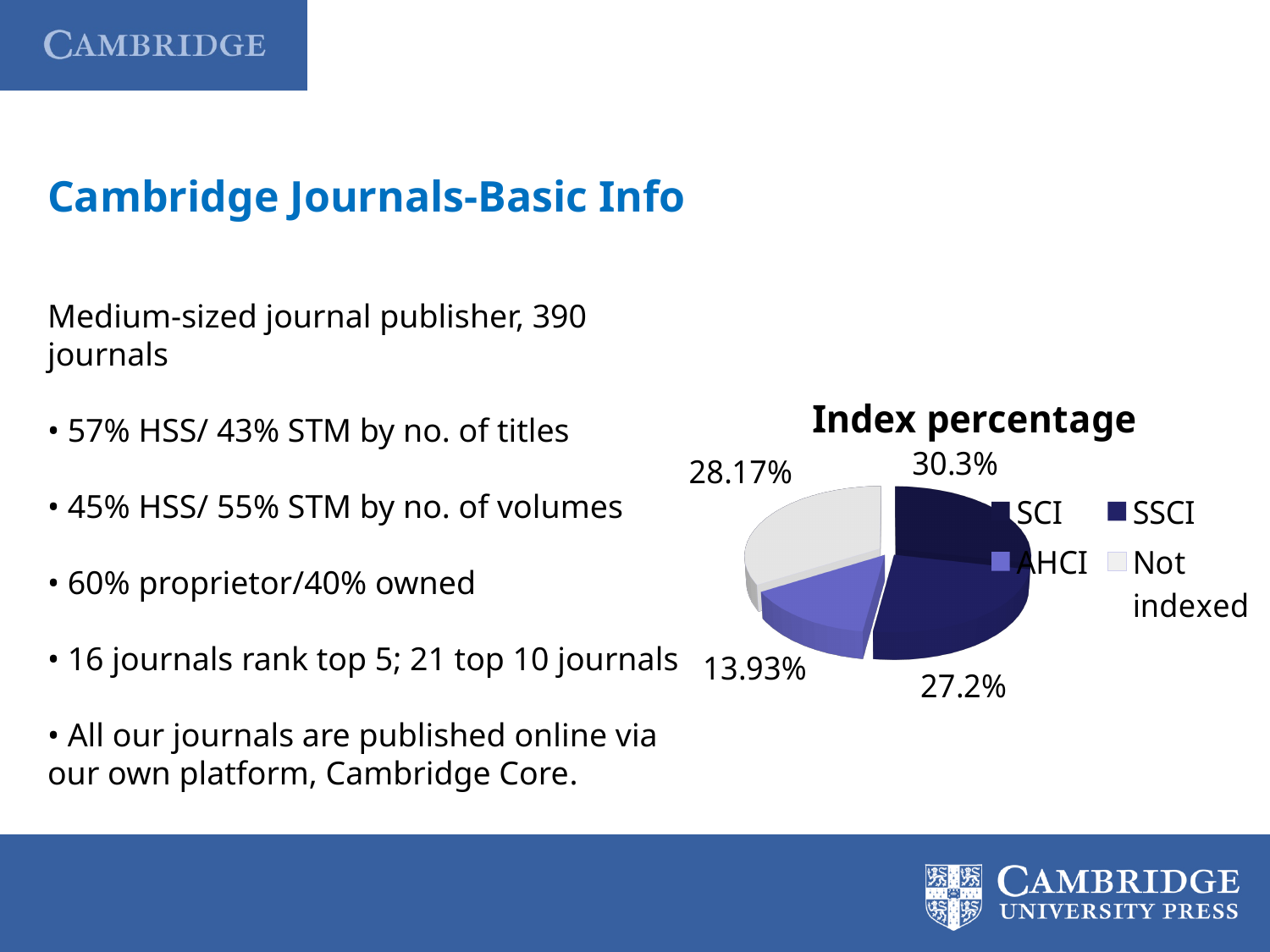
What is the difference between the SCI share and the AHCI share in the Index percentage chart? 16.37% Which is larger in the Index percentage chart, the SSCI share or the Not indexed share? Not indexed Which category has the smallest share of the Index percentage pie? AHCI What kind of chart is shown on the slide? Pie chart Which category has the largest share of the Index percentage pie? SCI How many categories does the legend of the Index percentage chart list? 4 What percentage of the Index percentage pie is SSCI? 27.2% What percentage of the Index percentage pie is Not indexed? 28.17% Which legend entry in the Index percentage chart is shown in white? Not indexed What is the title of the chart? Index percentage What percentage of the Index percentage pie is SCI? 30.3% What percentage of the Index percentage pie is AHCI? 13.93%